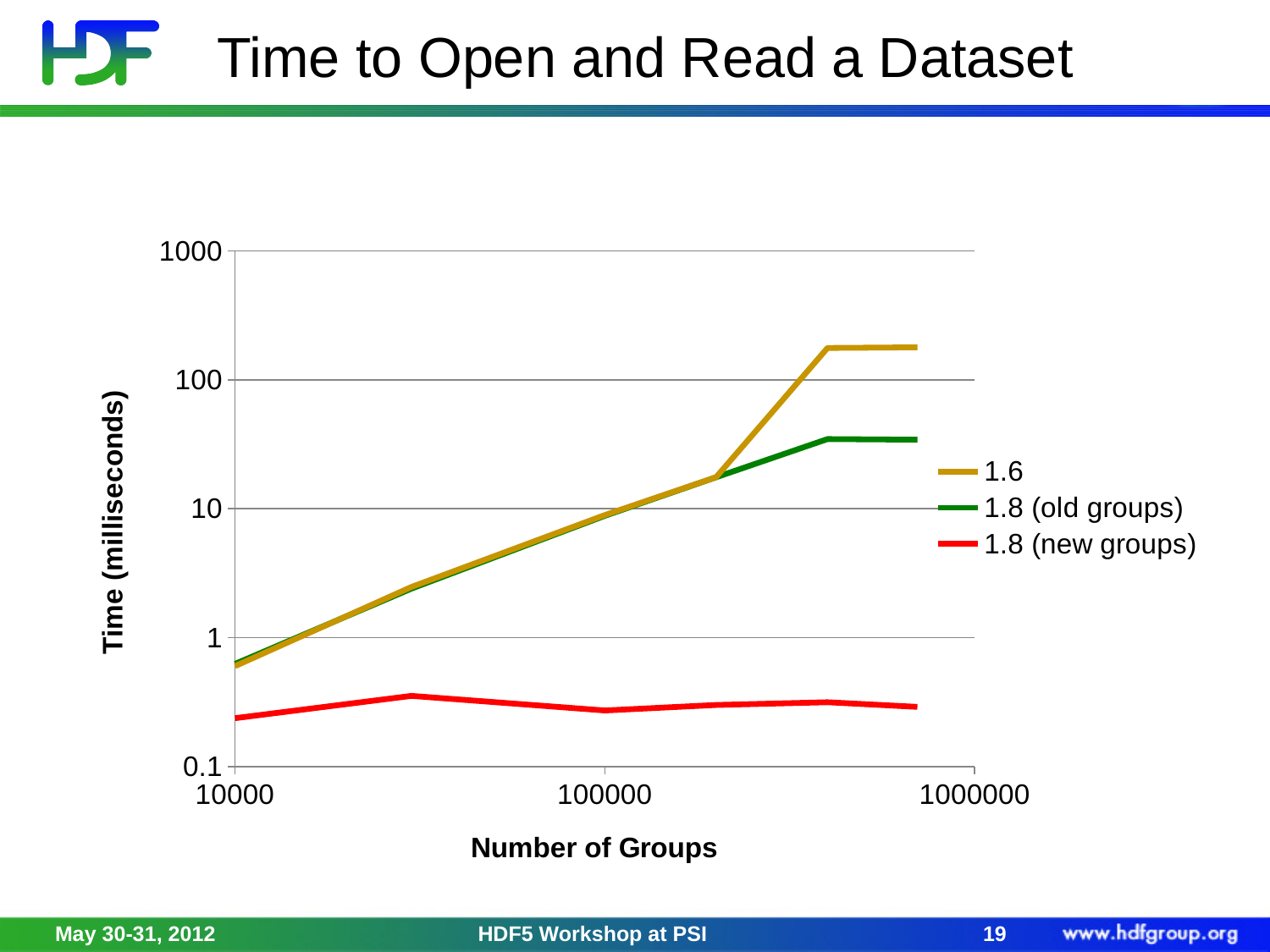
What kind of chart is shown on the slide? line chart Which series is drawn in red? 1.8 (new groups) At the largest number of groups, which series has the higher time: 1.6 or 1.8 (old groups)? 1.6 At 10000 groups, which series has the higher time: 1.8 (old groups) or 1.8 (new groups)? 1.8 (old groups) How many series does the legend list? 3 Is the value for the 1.6 series at 10000 groups greater or less than 1? less Is the value for the 1.8 (new groups) series at 10000 groups greater or less than 1? less Is the value for the 1.6 series at the largest number of groups greater or less than 100? greater Does the time for the 1.6 series rise or fall as the number of groups increases? rise Which series has the highest time at the largest number of groups? 1.6 What is the title of the chart? Time to Open and Read a Dataset